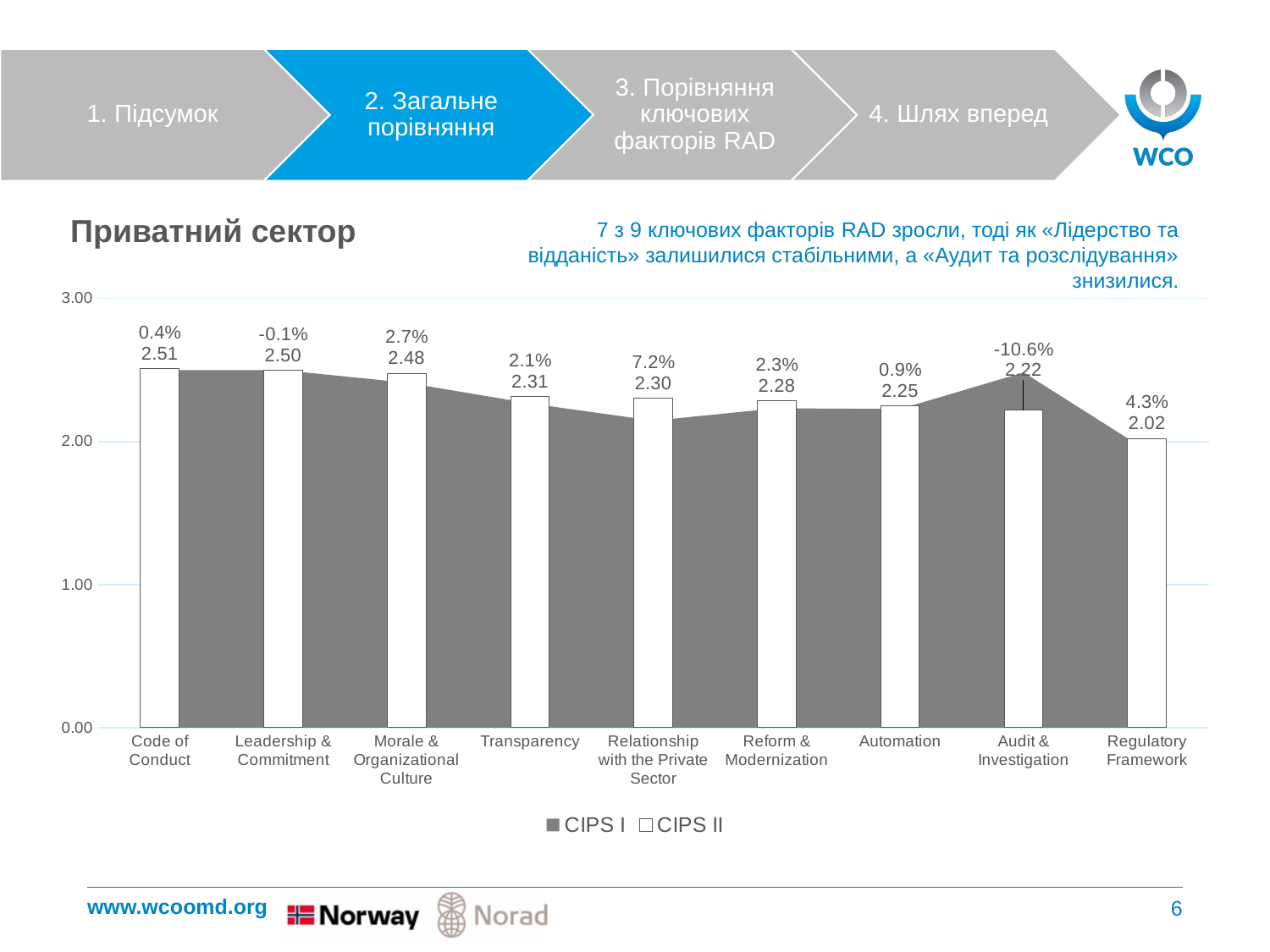
Is the CIPS I value for Audit & Investigation greater or less than 2.00? greater How many categories are shown on the x axis? 9 Which category has the lowest CIPS II value? Regulatory Framework What is the CIPS II value for Transparency? 2.31 How many series does the legend list? 2 What is the difference between the CIPS II values for Code of Conduct and Regulatory Framework? 0.49 What percentage change is shown above the Relationship with the Private Sector bar? 7.2% What percentage change is shown above the Audit & Investigation bar? -10.6% Which category has the highest CIPS II value? Code of Conduct Which has the larger CIPS II value, Morale & Organizational Culture or Automation? Morale & Organizational Culture Do the CIPS II values rise or fall from left to right across the categories? fall What is the CIPS II value for Code of Conduct? 2.51